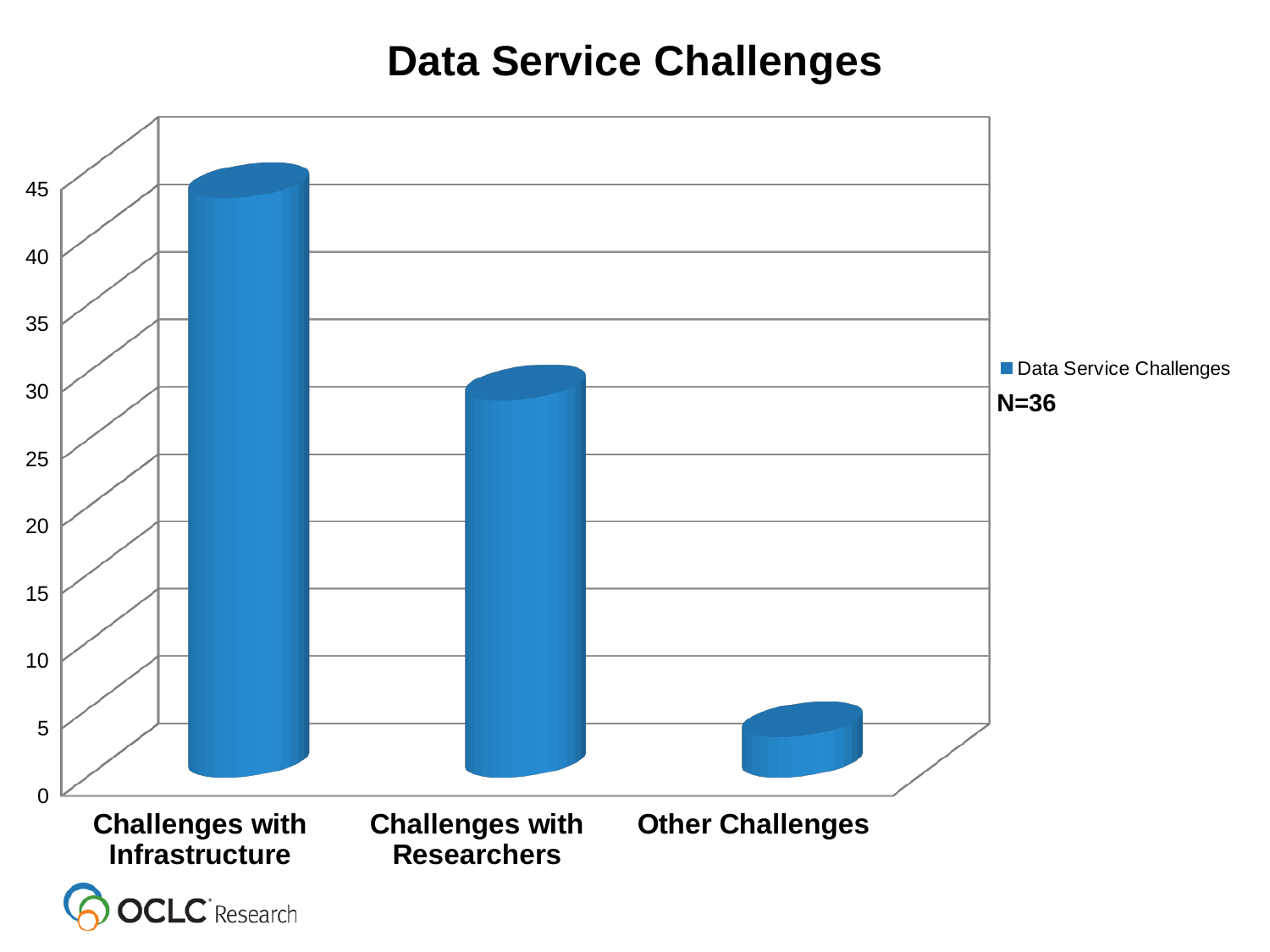
How many categories are shown on the x axis of the chart? 3 Do the values rise or fall moving from left to right along the x axis? fall How many series does the legend list? 1 Which category has the highest value? Challenges with Infrastructure What kind of chart is shown on the slide? bar chart Which category has the lowest value? Other Challenges Is the value for Challenges with Researchers greater or less than 25? greater What is the title of the chart? Data Service Challenges Which is larger, the value for Challenges with Researchers or the value for Other Challenges? Challenges with Researchers Is the value for Challenges with Infrastructure greater or less than 40? greater Is the value for Other Challenges greater or less than 10? less Which is larger, the value for Challenges with Infrastructure or the value for Challenges with Researchers? Challenges with Infrastructure